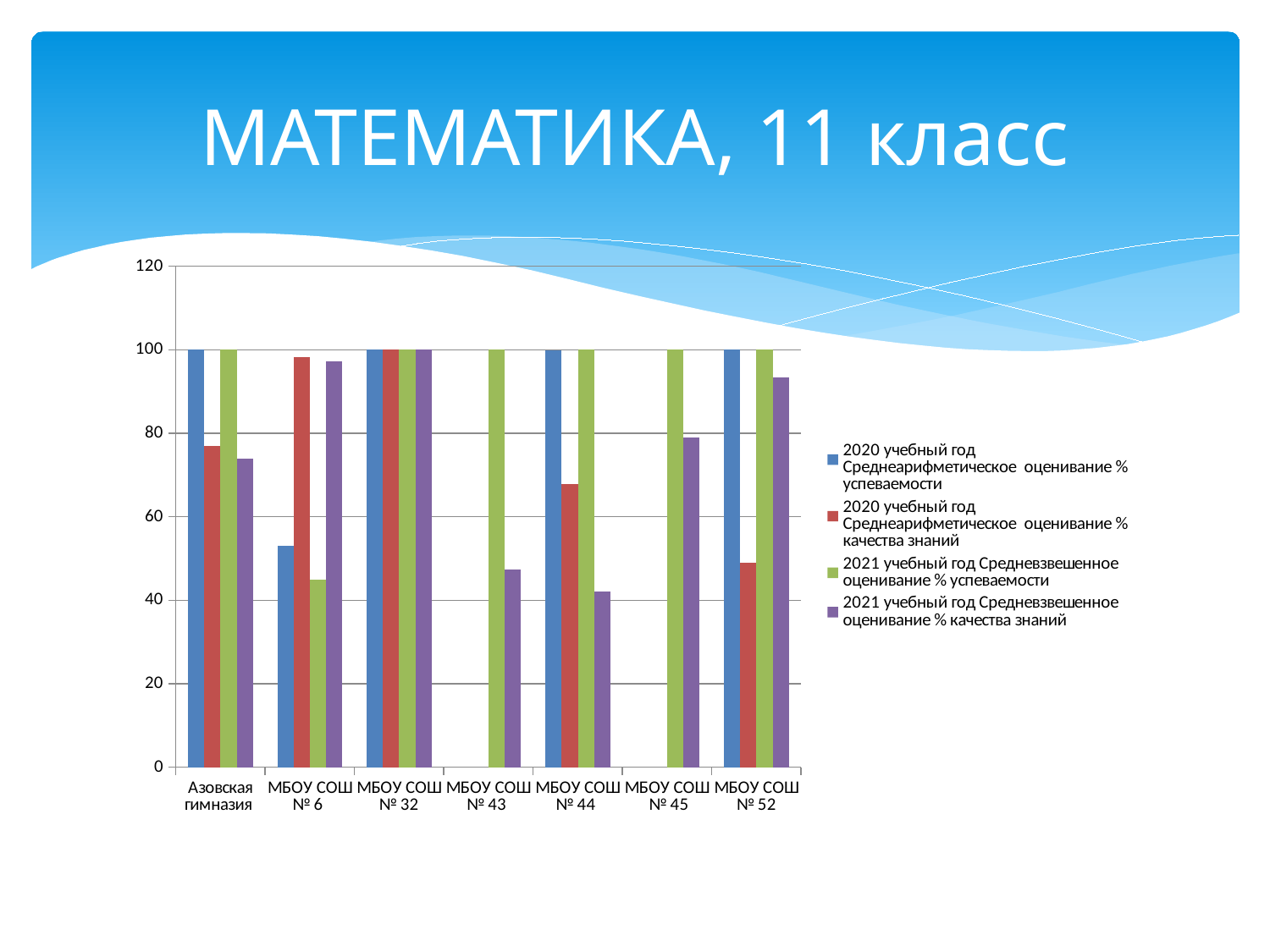
Which is larger: '2021 учебный год Средневзвешенное оценивание % качества знаний' for МБОУ СОШ № 52 or for МБОУ СОШ № 44? МБОУ СОШ № 52 Is the value of '2020 учебный год Среднеарифметическое оценивание % качества знаний' for МБОУ СОШ № 44 greater or less than 60? greater Which colour represents '2021 учебный год Средневзвешенное оценивание % качества знаний'? purple What is the title of the slide? МАТЕМАТИКА, 11 класс What is the value of '2021 учебный год Средневзвешенное оценивание % успеваемости' for МБОУ СОШ № 32? 100 How many schools (categories) are shown on the x axis? 7 What type of chart is shown on the slide? bar chart Is the value of '2020 учебный год Среднеарифметическое оценивание % успеваемости' for МБОУ СОШ № 6 greater or less than 60? less How many series does the legend list? 4 Is the value of '2021 учебный год Средневзвешенное оценивание % качества знаний' for МБОУ СОШ № 45 greater or less than 60? greater What is the value of '2020 учебный год Среднеарифметическое оценивание % успеваемости' for Азовская гимназия? 100